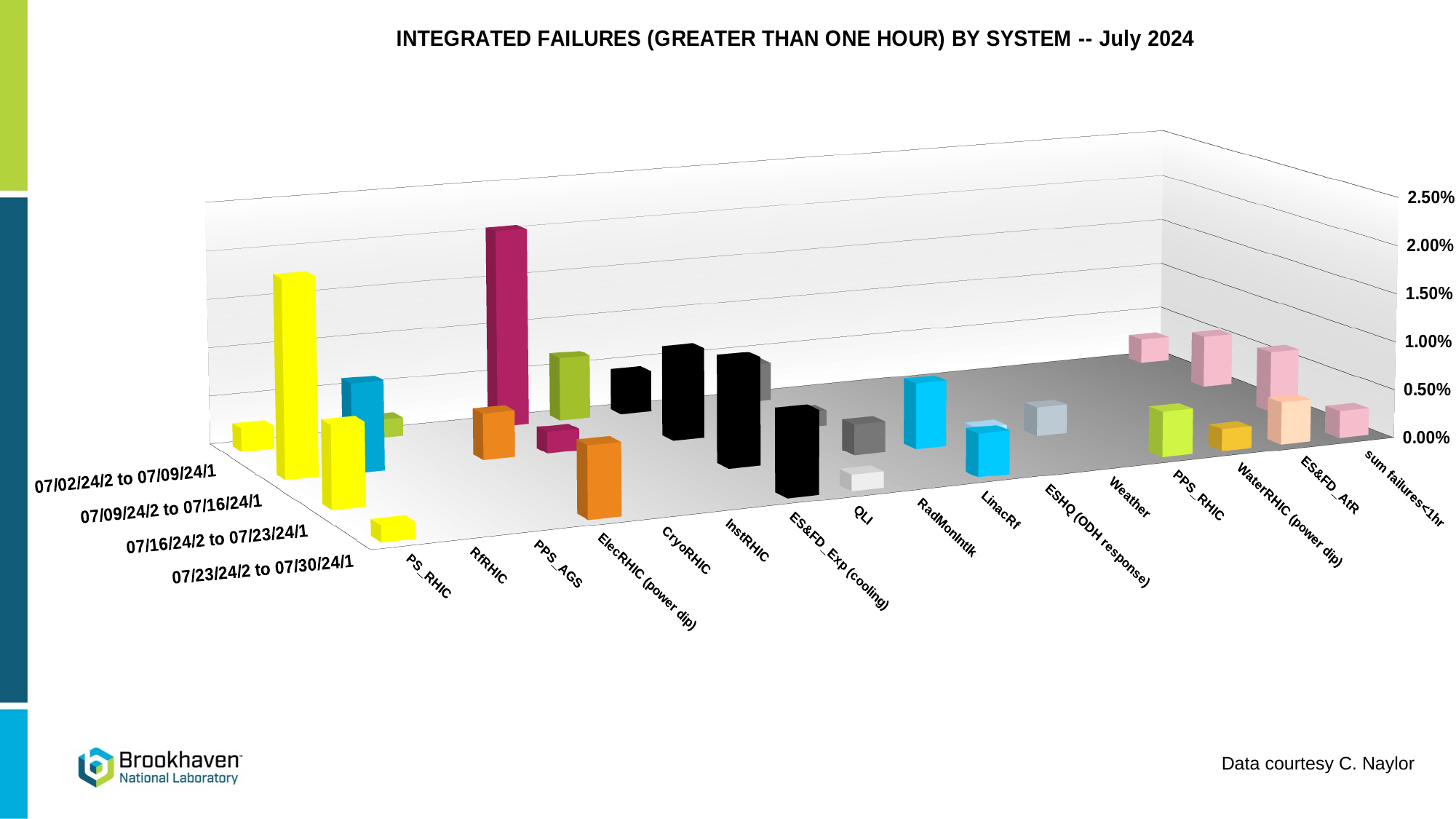
Is the tallest bar for RfRHIC greater or less than 1.50%? less Which system has the tallest bar in the chart? CryoRHIC What is the title of the chart? INTEGRATED FAILURES (GREATER THAN ONE HOUR) BY SYSTEM -- July 2024 What kind of chart is shown on the slide? bar chart Is the tallest bar for QLI greater or less than 0.50%? less Which system is listed last (rightmost) on the horizontal axis? sum failures<1hr What is the highest value shown on the vertical axis of the chart? 2.50% How many weekly periods are plotted along the depth axis of the chart? 4 Which has the taller tallest bar, RfRHIC or QLI? RfRHIC Is the tallest bar for ESHQ (ODH response) greater or less than 1.00%? less How many systems (categories) are listed along the horizontal axis of the chart? 16